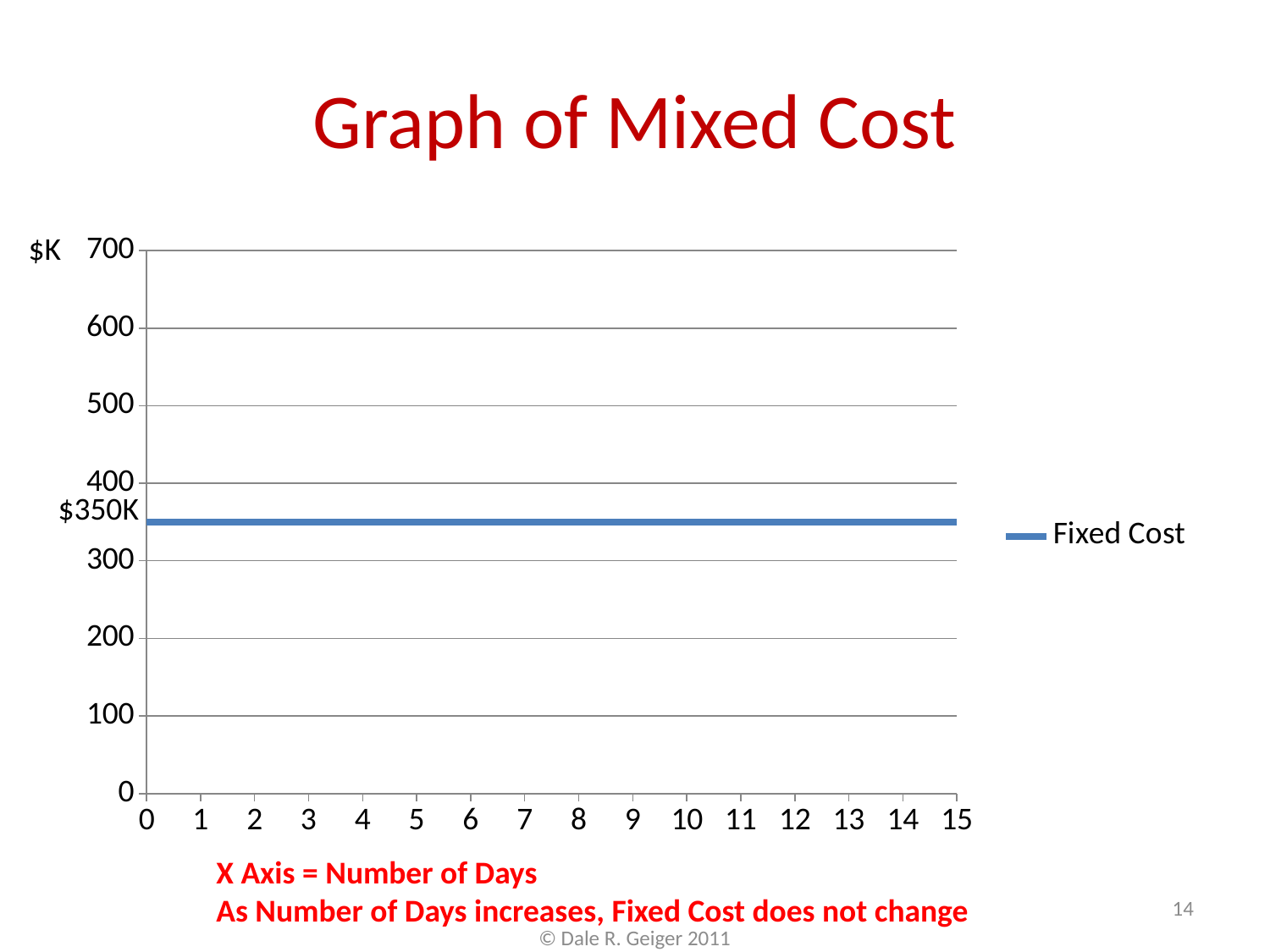
What is the value of Fixed Cost at 15 days? $350K Is the value for Fixed Cost at 10 days greater or less than 400? less What is the difference between the Fixed Cost at 1 day and at 14 days? $0K What is the value of Fixed Cost at 5 days? $350K What is the title of the chart on the slide? Graph of Mixed Cost What kind of chart is shown on the slide? line chart How many series does the legend list? 1 Is the value for Fixed Cost at 2 days greater or less than 300? greater What is the highest value labelled on the y axis? 700 Does the Fixed Cost line rise, fall, or stay flat as the number of days increases? stays flat How many tick marks are labelled on the x axis? 16 What is the name of the series shown in the legend? Fixed Cost